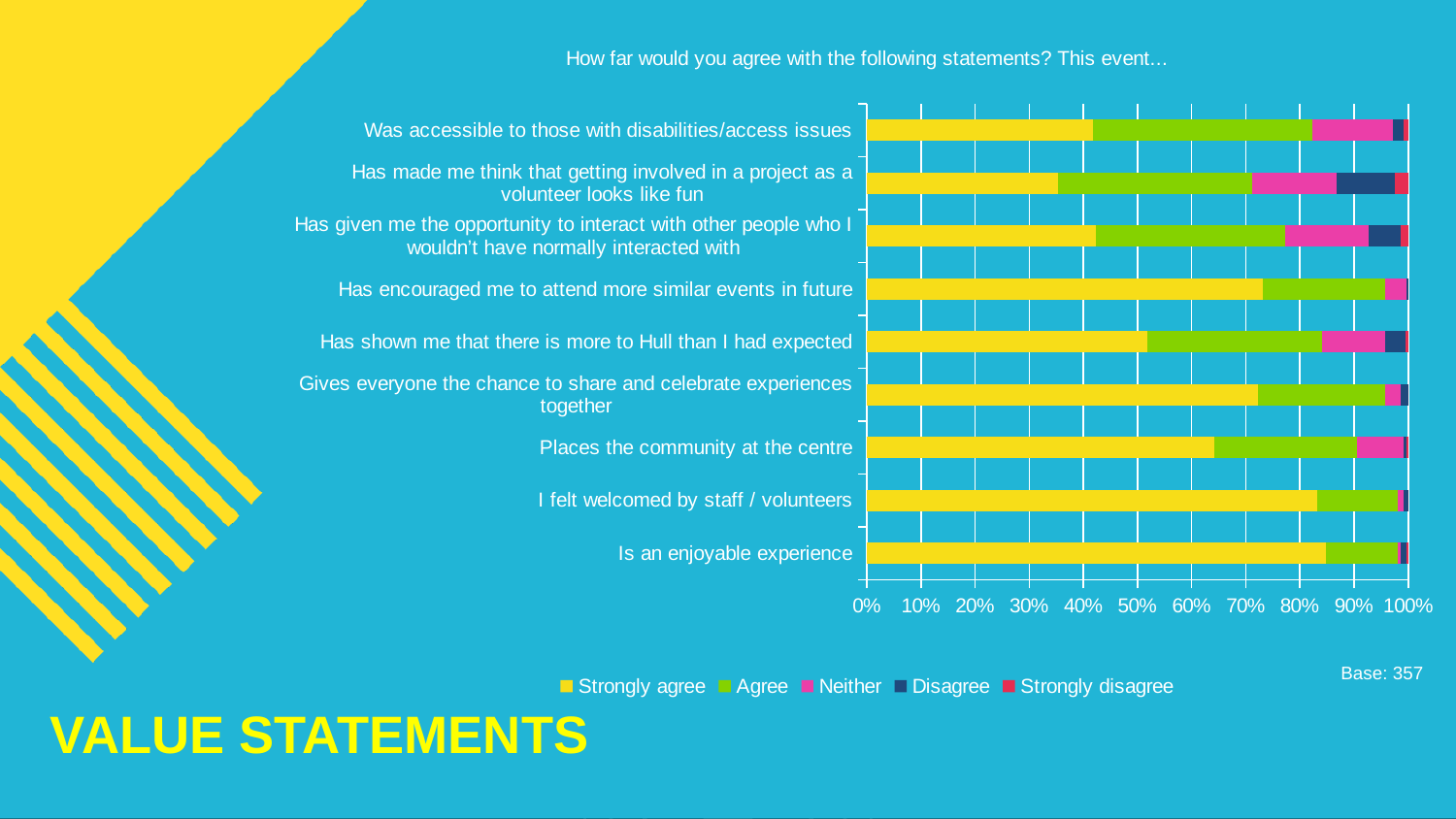
What is the question shown as the chart's title? How far would you agree with the following statements? This event… Is the 'Strongly agree' share for 'Has encouraged me to attend more similar events in future' greater or less than 70%? greater What base (number of respondents) is stated for the chart? Base: 357 Is the 'Strongly agree' share for 'Has made me think that getting involved in a project as a volunteer looks like fun' greater or less than 40%? less What kind of chart is shown on the slide? Stacked bar chart Is the 'Strongly agree' share for 'Has shown me that there is more to Hull than I had expected' greater or less than 60%? less Which has the larger 'Strongly agree' share: 'Places the community at the centre' or 'Was accessible to those with disabilities/access issues'? Places the community at the centre How many series does the chart legend list? 5 Which statement has the smallest 'Strongly agree' share? Has made me think that getting involved in a project as a volunteer looks like fun How many statements (categories) are plotted on the chart? 9